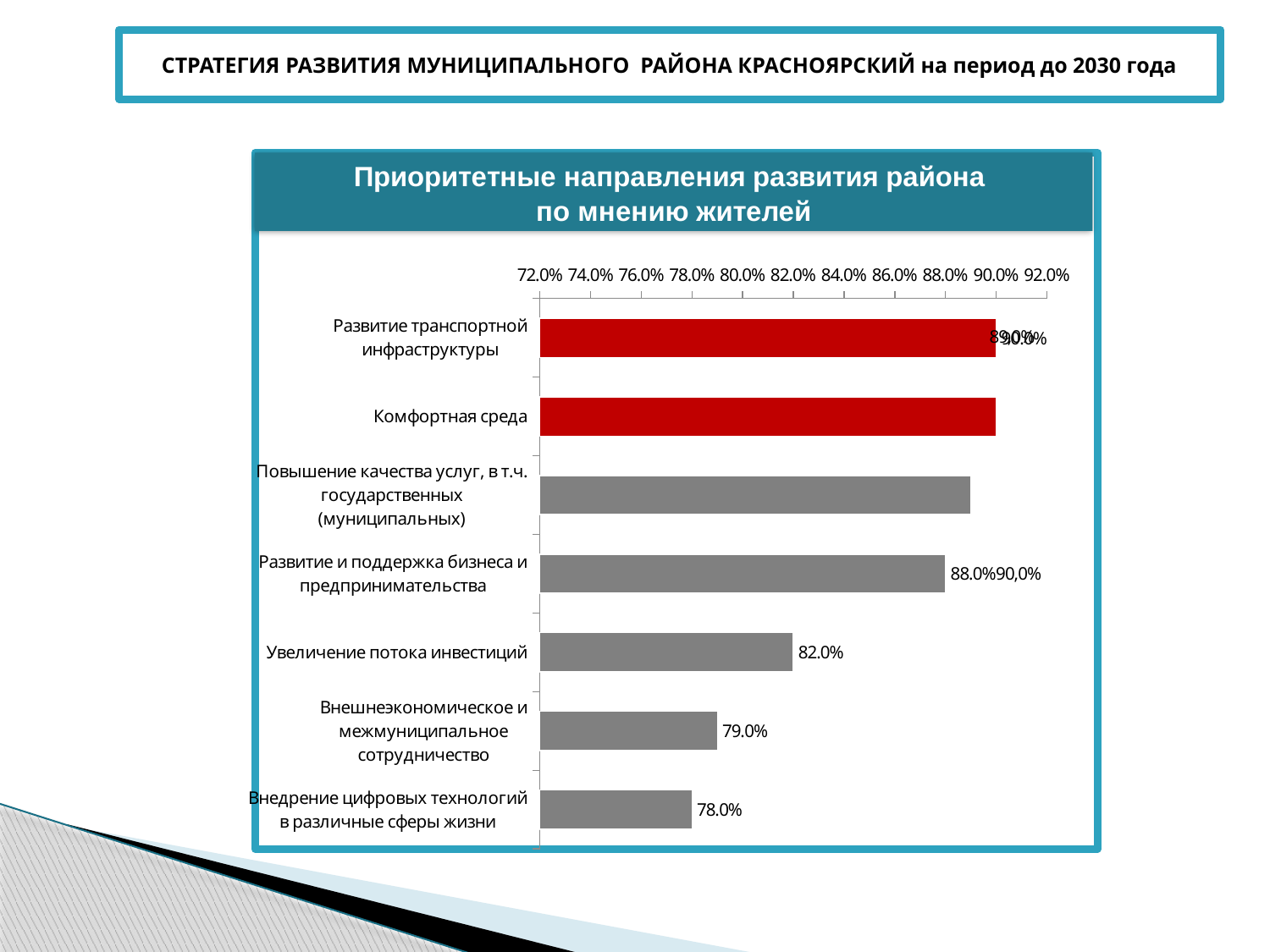
What is the difference between the values for "Увеличение потока инвестиций" and "Внедрение цифровых технологий в различные сферы жизни"? 4.0% Which is larger: the value for "Увеличение потока инвестиций" or for "Внешнеэкономическое и межмуниципальное сотрудничество"? Увеличение потока инвестиций How many categories (priority directions) are shown in the chart? 7 Is the value for "Комфортная среда" greater or less than 86.0%? greater Which category has the lowest value? Внедрение цифровых технологий в различные сферы жизни What type of chart is shown on the slide? bar chart Which two categories are highlighted with red bars? Развитие транспортной инфраструктуры and Комфортная среда Is the value for "Повышение качества услуг, в т.ч. государственных (муниципальных)" greater or less than 84.0%? greater What is the value for "Увеличение потока инвестиций"? 82.0% What is the value for "Внешнеэкономическое и межмуниципальное сотрудничество"? 79.0% What is the title of the chart? Приоритетные направления развития района по мнению жителей What is the value for "Внедрение цифровых технологий в различные сферы жизни"? 78.0%